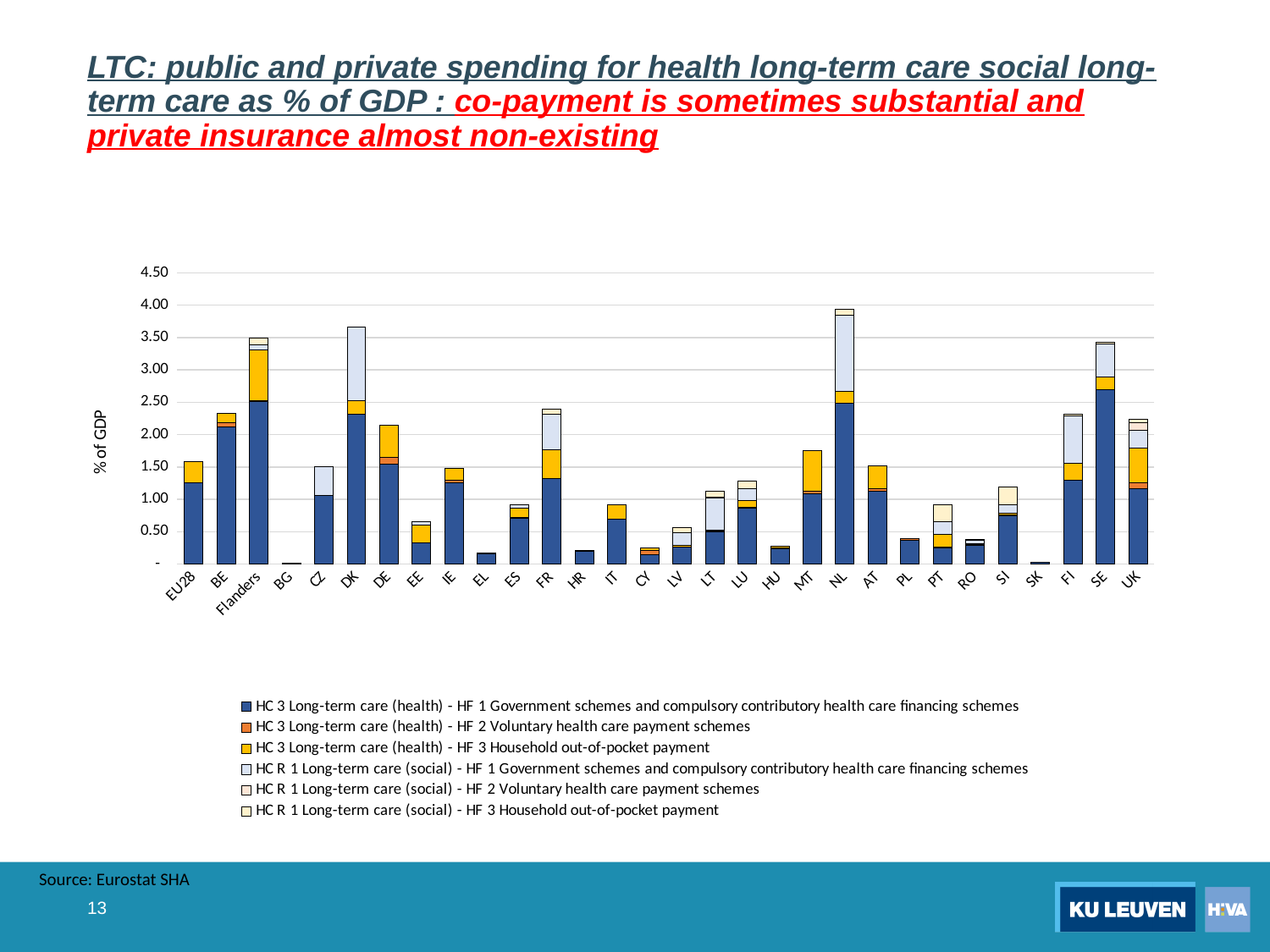
Which has the larger total bar, FI or PL? FI What is the label on the vertical axis? % of GDP Is the total bar for BE greater or less than 2.00? greater How many series does the legend list? 6 How many countries/regions are shown along the x axis? 30 What kind of chart is shown on the slide? Stacked bar chart Is the total bar for EU28 greater or less than 2.00? less Is the total bar for NL greater or less than 3.50? greater Which has the larger total bar, SE or UK? SE Which country has the tallest total bar? NL